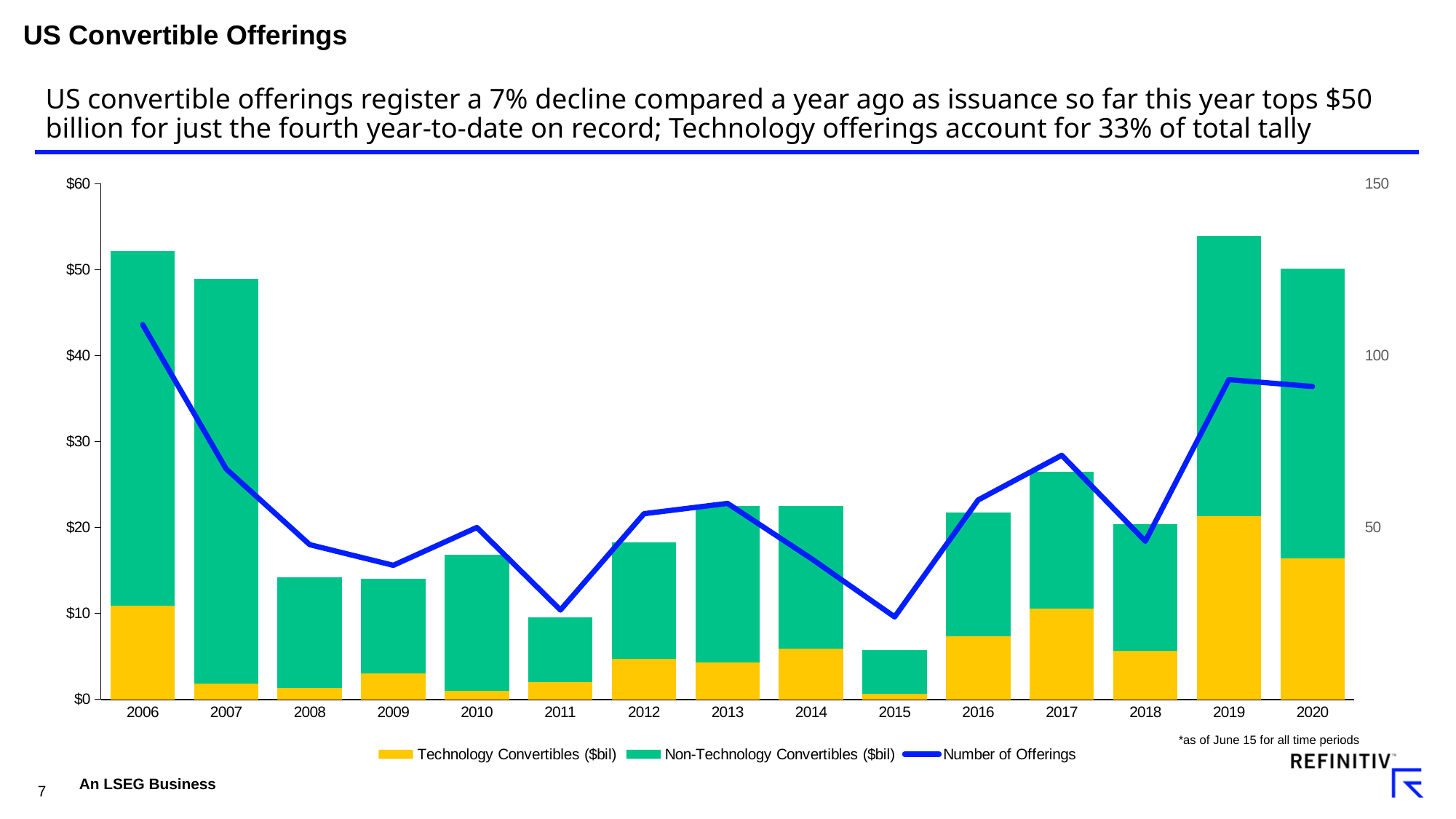
Do the total bars rise or fall from 2015 to 2019? rise In which year is the Number of Offerings line at its highest? 2006 How many years are shown on the x axis of the chart? 15 Which year has the larger total bar, 2007 or 2008? 2007 Which year has the shortest total bar? 2015 How many series does the legend list? 3 What kind of chart is shown on the slide? A stacked bar chart with a line Which year has the tallest total bar (Technology plus Non-Technology Convertibles)? 2019 Is the Technology Convertibles value for 2020 greater or less than $10? greater Is the Number of Offerings for 2011 greater or less than 50? less Which year has the largest Technology Convertibles segment? 2019 Is the total bar for 2008 greater or less than $20? less